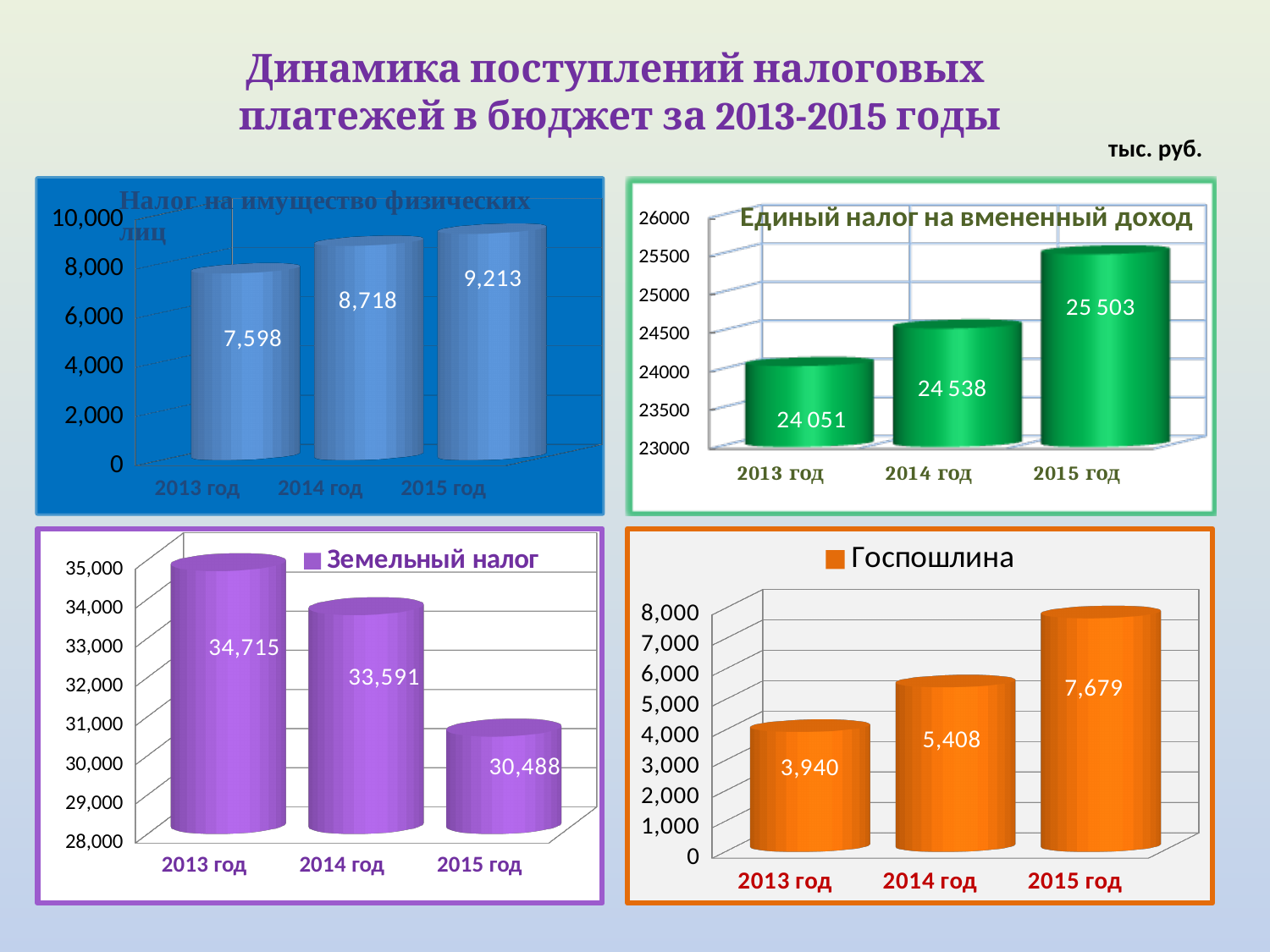
In the 'Единый налог на вмененный доход' chart, what is the value for 2015 год? 25 503 In the 'Госпошлина' chart, what is the value for 2014 год? 5,408 Do the values in the 'Земельный налог' chart rise or fall from 2013 год to 2015 год? fall In the 'Единый налог на вмененный доход' chart, which is larger: the value for 2013 год or 2014 год? 2014 год How many years (categories) are shown in the 'Госпошлина' chart? 3 In the 'Госпошлина' chart, which year has the highest value? 2015 год What kind of chart is the 'Единый налог на вмененный доход' chart? bar chart In the 'Госпошлина' chart, what is the difference between the 2015 год and 2013 год values? 3,739 In the 'Земельный налог' chart, what is the value for 2013 год? 34,715 In the 'Налог на имущество физических лиц' chart, what is the value for 2014 год? 8,718 In the 'Налог на имущество физических лиц' chart, what is the difference between the 2015 год and 2013 год values? 1,615 In the 'Земельный налог' chart, which year has the lowest value? 2015 год